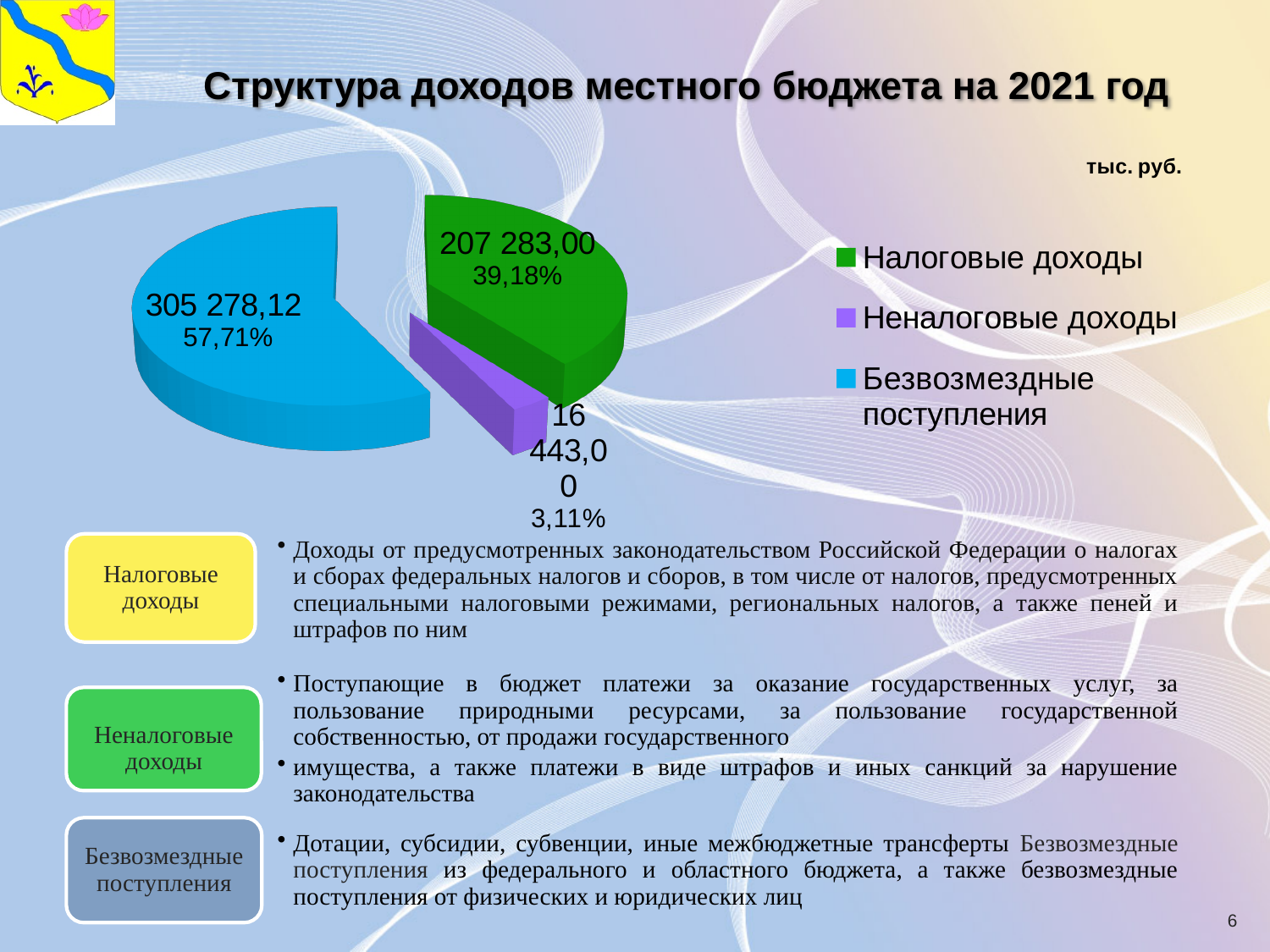
What is the difference between the values for Безвозмездные поступления and Налоговые доходы? 97 995,12 What is the title of the chart on the slide? Структура доходов местного бюджета на 2021 год What share of the pie does Налоговые доходы represent? 39,18% How many categories does the pie chart show? 3 What share of the pie does Безвозмездные поступления represent? 57,71% What type of chart is shown on the slide? Pie chart Which category has the largest slice of the pie? Безвозмездные поступления What share of the pie does Неналоговые доходы represent? 3,11% What is the value for Неналоговые доходы? 16 443,00 What is the value for Налоговые доходы? 207 283,00 What is the value for Безвозмездные поступления? 305 278,12 Which category has the smallest slice of the pie? Неналоговые доходы